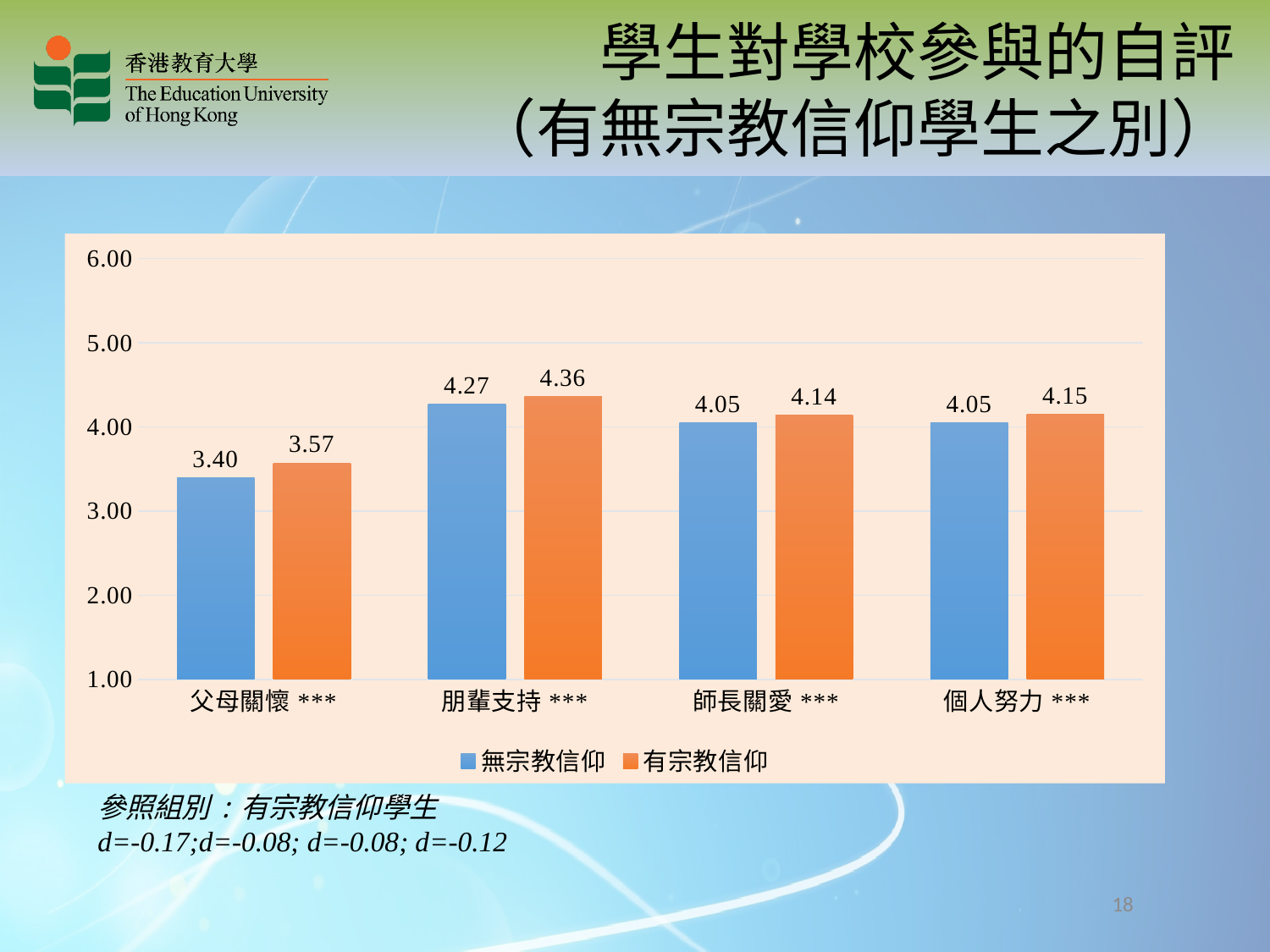
In the 師長關愛 category, which series has the larger value, 無宗教信仰 or 有宗教信仰? 有宗教信仰 Is the value for 無宗教信仰 in the 父母關懷 category greater or less than 4.00? less What kind of chart is shown on the slide? bar chart What is the value for 有宗教信仰 in the 個人努力 category? 4.15 How many categories are shown on the x axis? 4 How many series does the legend list? 2 What is the value for 有宗教信仰 in the 朋輩支持 category? 4.36 What is the difference between the 有宗教信仰 and 無宗教信仰 values in the 父母關懷 category? 0.17 What is the value for 無宗教信仰 in the 父母關懷 category? 3.40 Which category has the highest value for 無宗教信仰? 朋輩支持 Which colour represents the 有宗教信仰 series? orange Which category has the lowest value for 有宗教信仰? 父母關懷